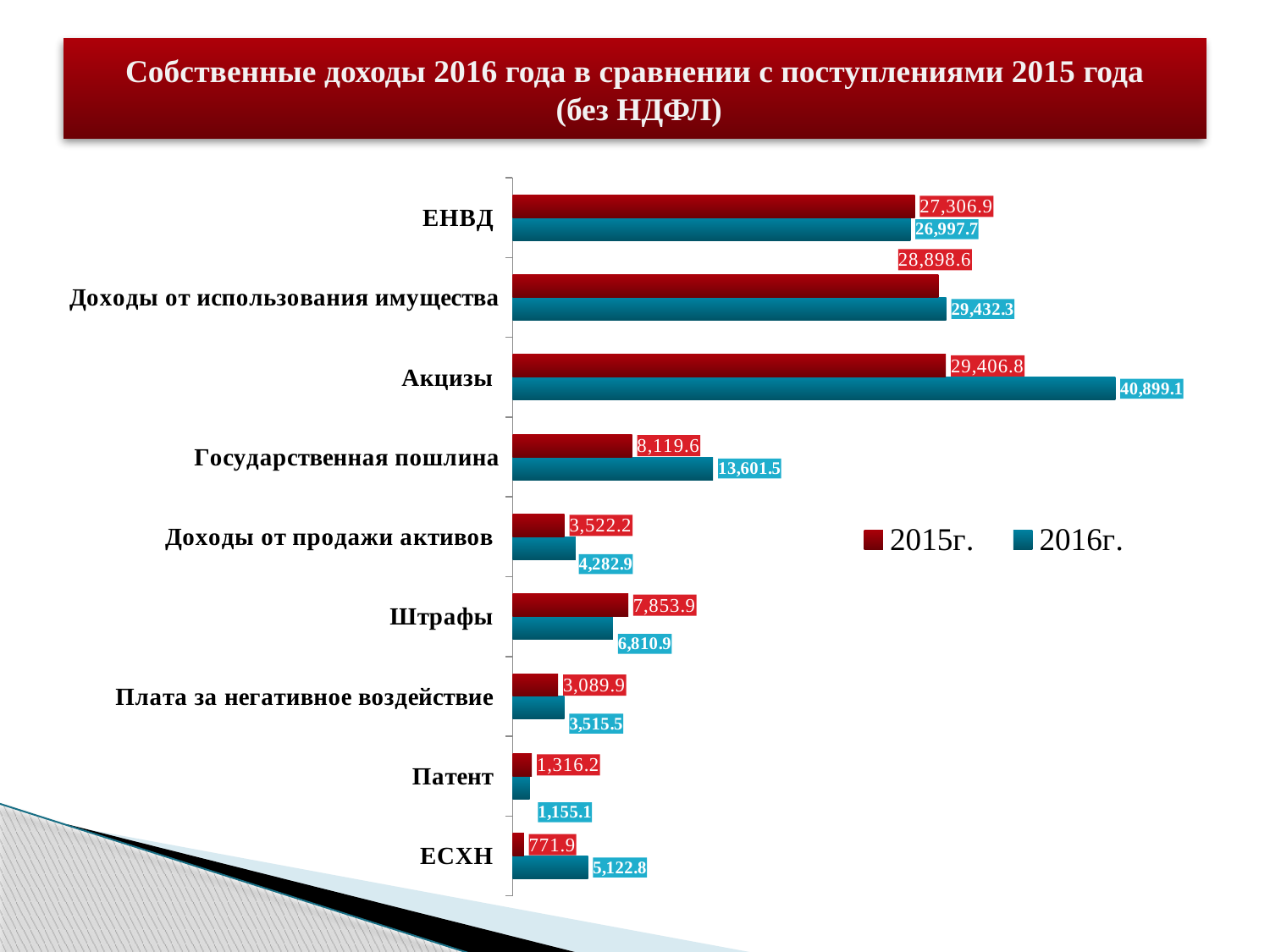
What kind of chart is shown on the slide? Bar chart What is the difference between the 2015г. and 2016г. values for Штрафы? 1,043.0 Which category has the lowest 2015г. value? ЕСХН How many categories are shown on the chart? 9 Which category has the lowest 2016г. value? Патент Which category has the highest 2016г. value? Акцизы What is the 2015г. value for Акцизы? 29,406.8 How many series does the legend list? 2 What is the difference between the 2016г. and 2015г. values for Акцизы? 11,492.3 For Патент, which year has the larger value, 2015г. or 2016г.? 2015г. What is the 2016г. value for Государственная пошлина? 13,601.5 What is the 2016г. value for ЕСХН? 5,122.8